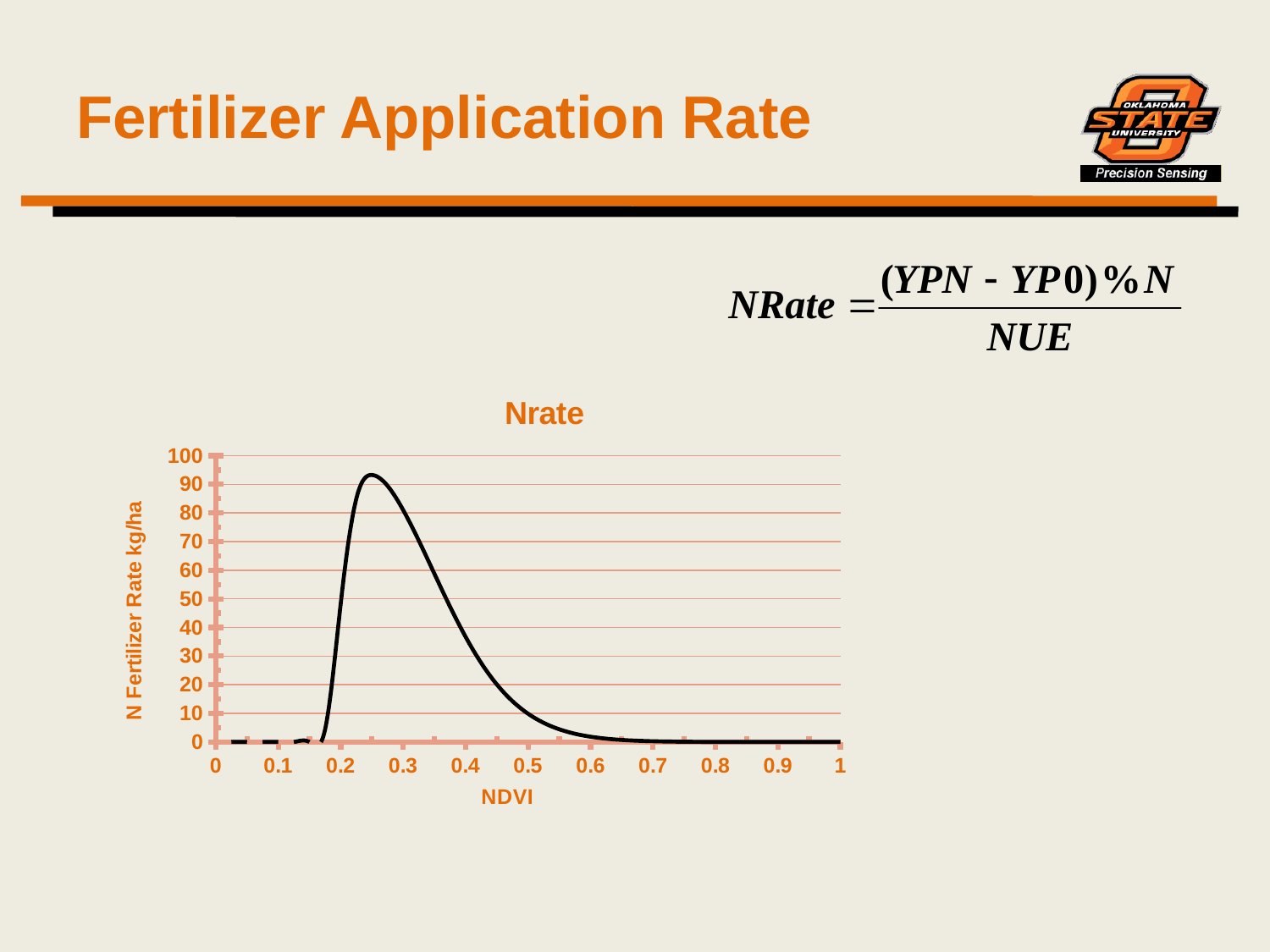
Is the value for NDVI 0.8 greater or less than 10? less Is the value for NDVI 0.1 greater or less than 10? less What kind of chart is shown on the slide? line chart Which has the larger value, NDVI 0.4 or NDVI 0.7? NDVI 0.4 Is the value for NDVI 0.6 greater or less than 10? less Which has the larger value, NDVI 0.3 or NDVI 0.5? NDVI 0.3 What is the label of the y axis of the chart? N Fertilizer Rate kg/ha What is the title of the chart? Nrate Do the values rise or fall as NDVI increases from 0.3 to 0.6? fall